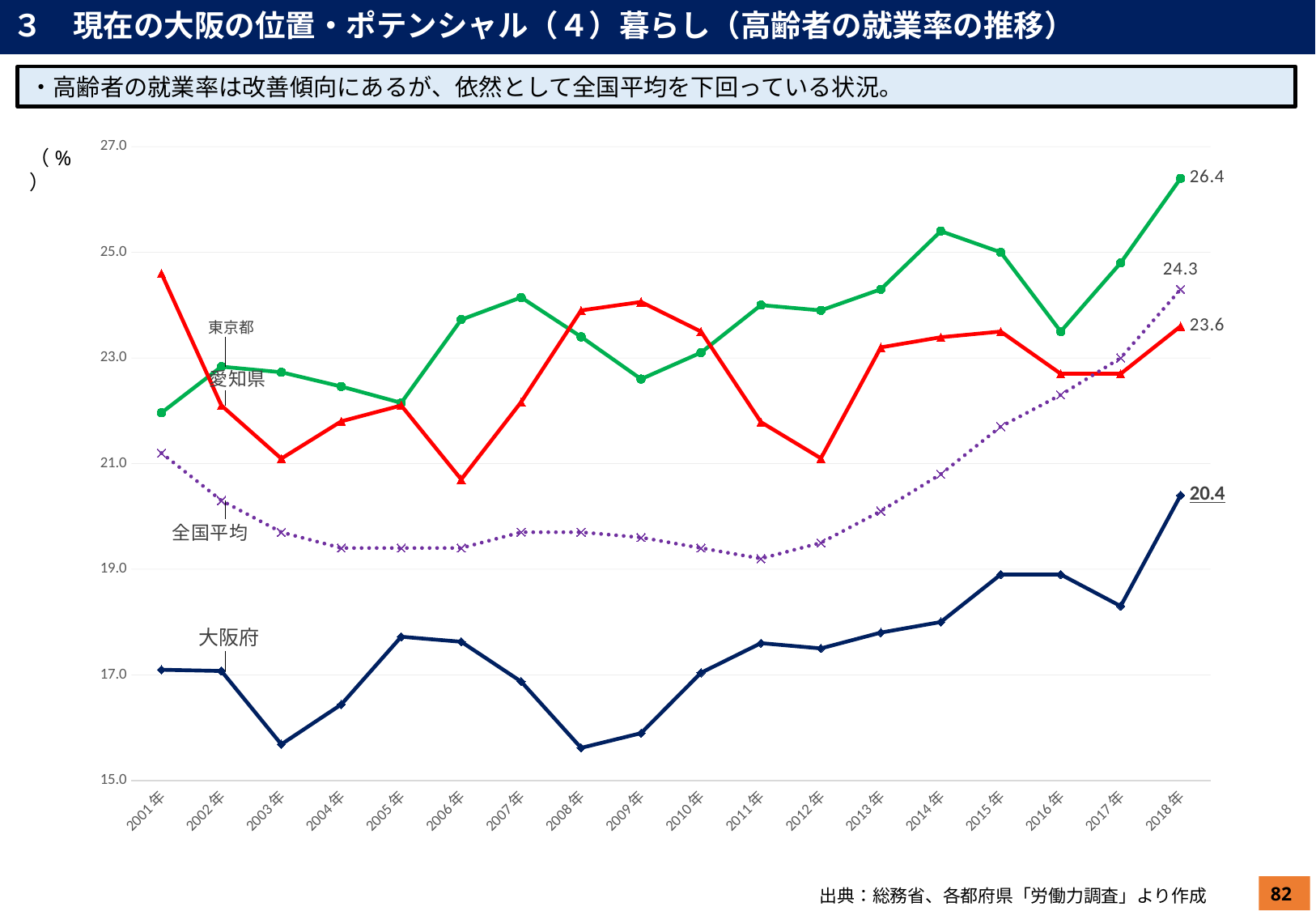
What is the value for 東京都 in 2018年? 26.4 How many series are plotted on the chart? 4 Which series has the lowest value in 2018年? 大阪府 Which series has the highest value in 2018年? 東京都 What is the difference between the 2018年 values for 東京都 and 大阪府? 6.0 Is the value for 大阪府 in 2008年 greater or less than 17.0? less What is the value for 全国平均 in 2018年? 24.3 How many years are shown on the x axis? 18 What kind of chart is shown on the slide? line chart In 2018年, which is larger: the value for 全国平均 or the value for 愛知県? 全国平均 What is the value for 愛知県 in 2018年? 23.6 What is the value for 大阪府 in 2018年? 20.4